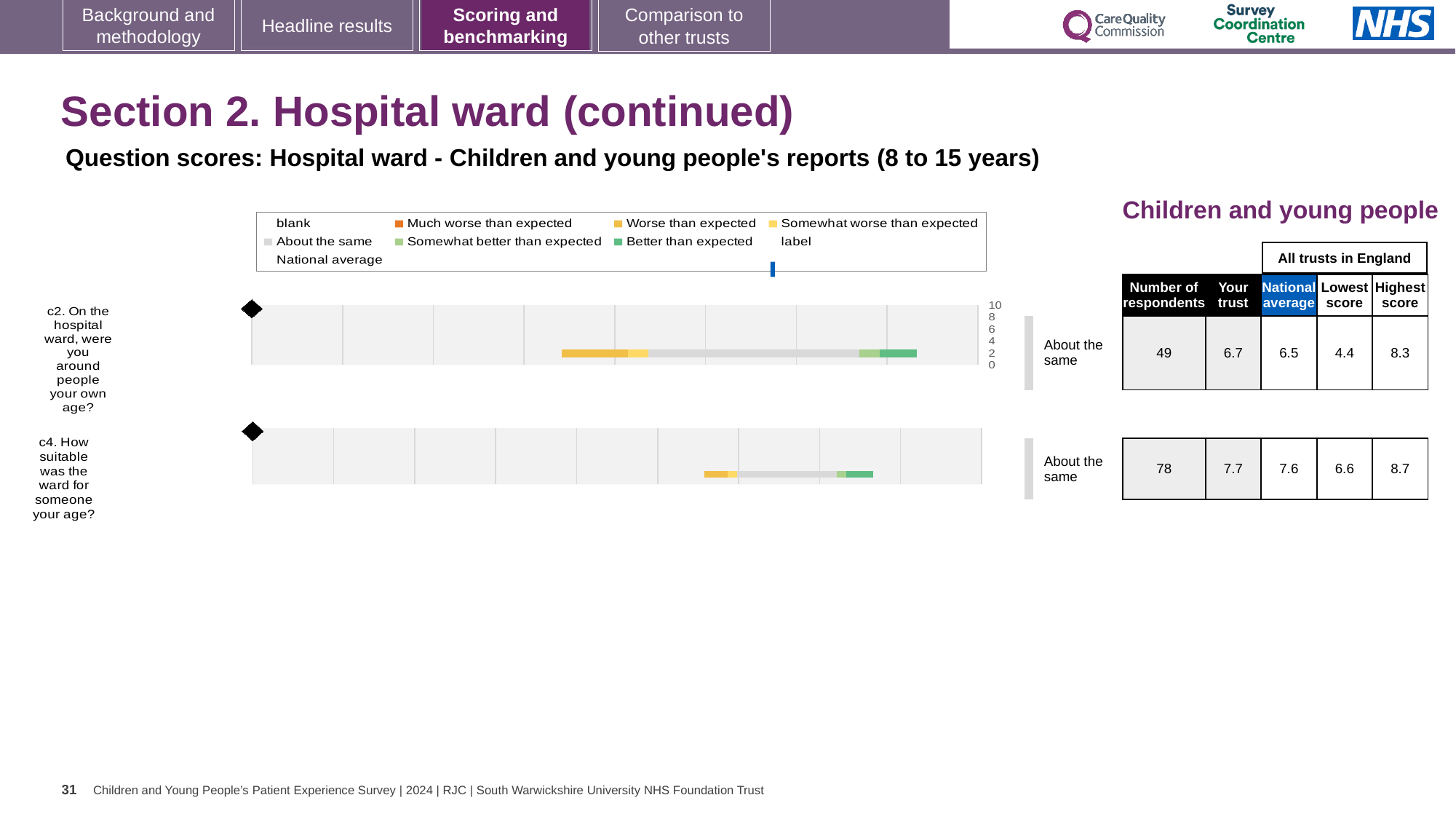
Which question has the higher 'Your trust' score, c2 or c4? c4 What is the difference between the highest and lowest trust scores for question c2? 3.9 What kind of chart is used to show the question scores for c2 and c4? Bar chart How many questions (c2 and c4) are plotted on the slide? 2 How many respondents answered question c4? 78 What is the highest score across all trusts in England for question c4? 8.7 What is the heading above the table to the right of the charts? Children and young people What benchmark category is shown for question c2? About the same What is the 'Your trust' score for question c2 (On the hospital ward, were you around people your own age?)? 6.7 By how much does the trust's score for c4 exceed the national average for c4? 0.1 What is the national average score for question c4 (How suitable was the ward for someone your age?)? 7.6 What is the lowest score across all trusts in England for question c2? 4.4